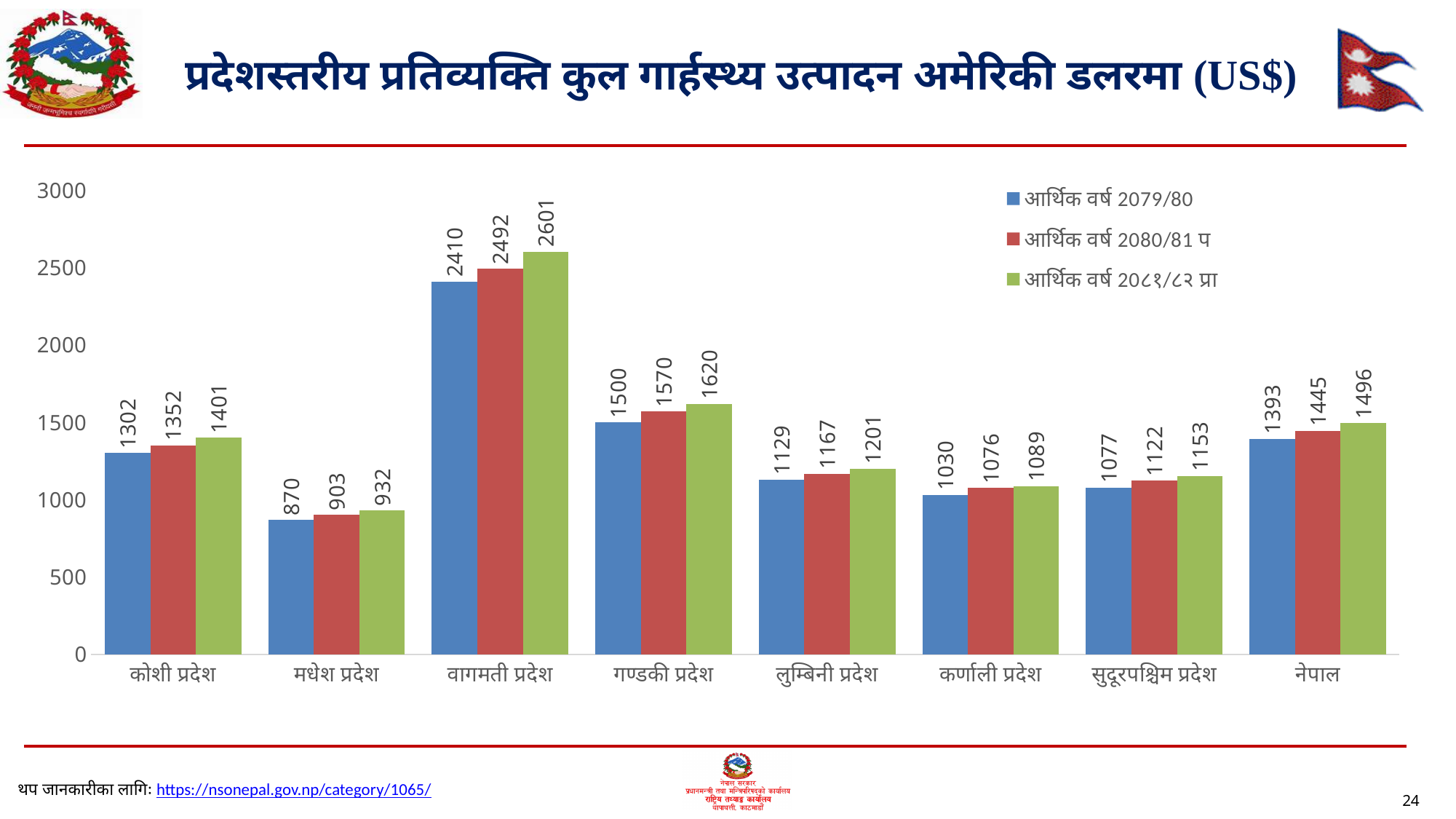
Which category has the highest value in the आर्थिक वर्ष २०८१/८२ प्रा series? वागमती प्रदेश How many categories are shown on the x axis? 8 Is the value for लुम्बिनी प्रदेश in the आर्थिक वर्ष 2079/80 series greater or less than 1000? greater What is the difference between the आर्थिक वर्ष २०८१/८२ प्रा value and the आर्थिक वर्ष 2079/80 value for गण्डकी प्रदेश? 120 What kind of chart is shown on the slide? bar chart What is the value for नेपाल in the आर्थिक वर्ष २०८१/८२ प्रा series? 1496 What is the value for मधेश प्रदेश in the आर्थिक वर्ष 2080/81 प series? 903 Which category has the lowest value in the आर्थिक वर्ष 2079/80 series? मधेश प्रदेश Which colour represents the आर्थिक वर्ष 2080/81 प series? red What is the value for वागमती प्रदेश in the आर्थिक वर्ष 2079/80 series? 2410 How many series does the legend list? 3 Which is larger in the आर्थिक वर्ष 2080/81 प series: कर्णाली प्रदेश or सुदूरपश्चिम प्रदेश? सुदूरपश्चिम प्रदेश